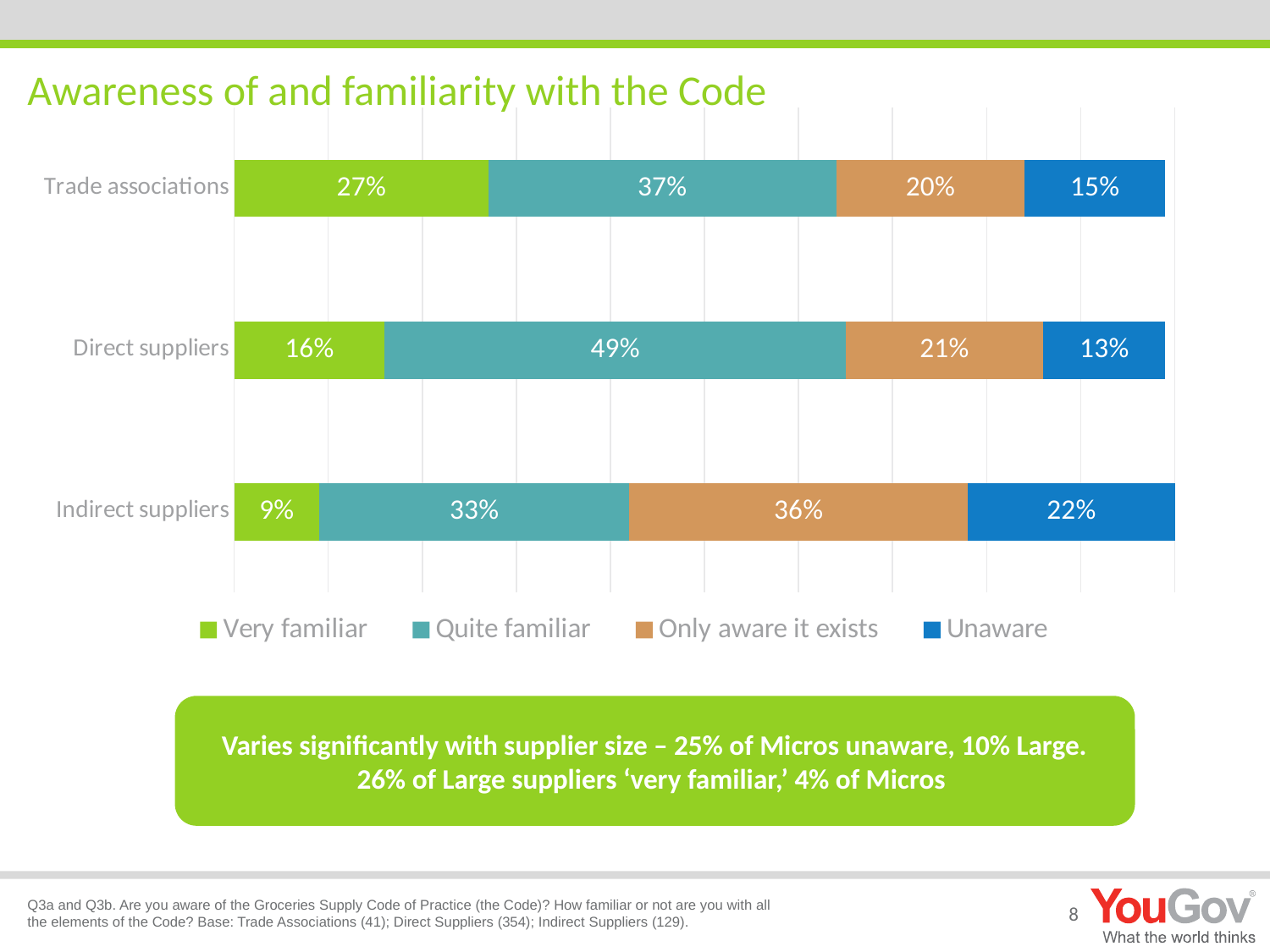
What percentage of Trade associations are 'Very familiar' with the Code? 27% What is the total of the stacked bar for Indirect suppliers? 100% Which is larger: the 'Only aware it exists' share for Indirect suppliers or for Trade associations? Indirect suppliers What percentage of Indirect suppliers are 'Unaware' of the Code? 22% How many groups (categories) are shown on the chart? 3 How many series does the legend list? 4 What percentage of Direct suppliers are 'Quite familiar' with the Code? 49% Which group has the highest share of 'Very familiar' respondents? Trade associations What percentage of Indirect suppliers are 'Only aware it exists'? 36% What is the difference between the 'Quite familiar' share for Direct suppliers and for Indirect suppliers? 16 percentage points Which group has the lowest share of 'Unaware' respondents? Direct suppliers What kind of chart is shown on the slide? Stacked bar chart